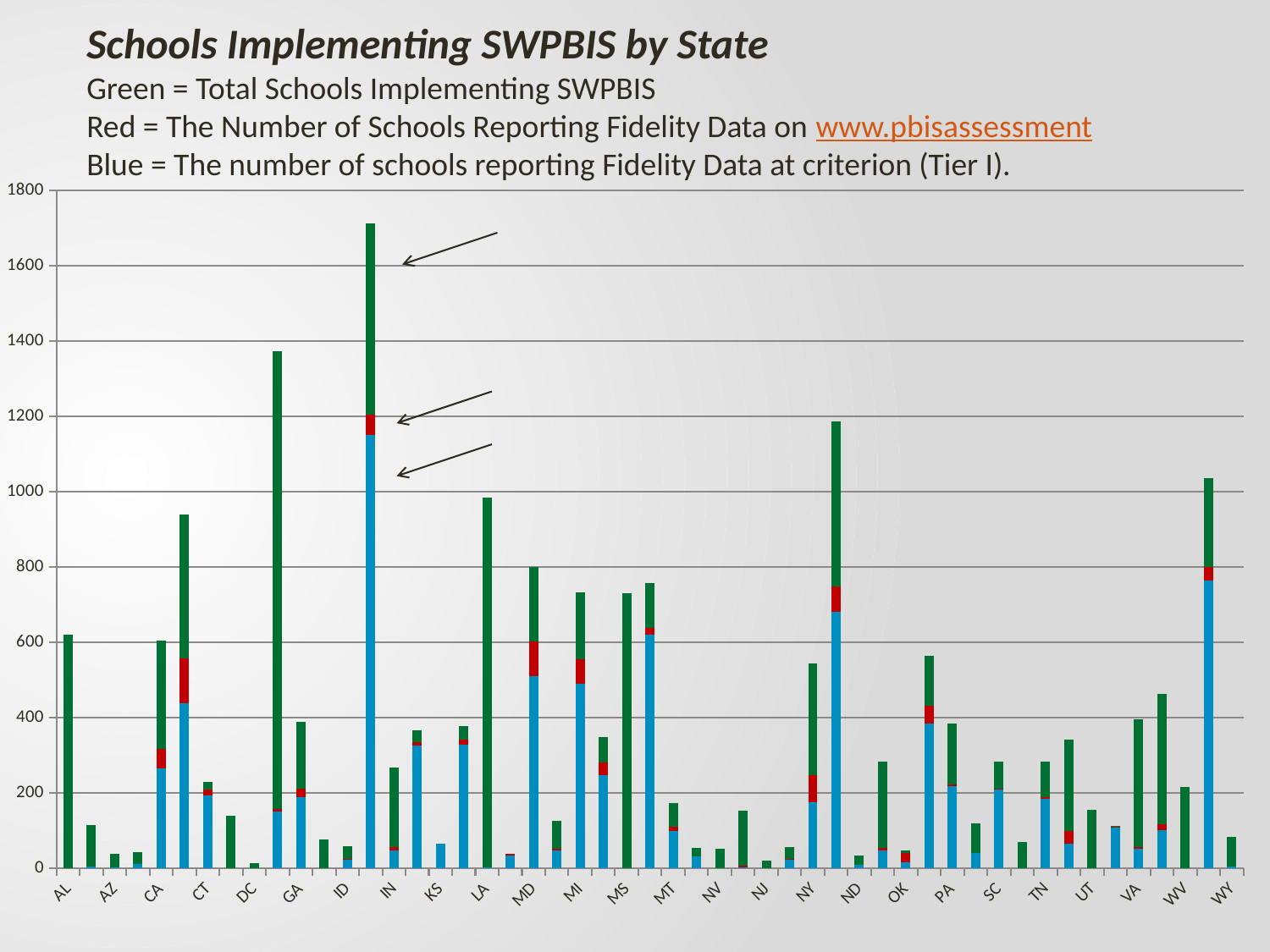
Is the total bar height for WY greater or less than 200? less Is the total bar height for NJ greater or less than 200? less What kind of chart is shown on the slide? bar chart According to the slide's key, what does the green colour represent? Total Schools Implementing SWPBIS How many series (colours) does the slide's key describe? 3 Which has the taller total bar, LA or DC? LA Is the total bar height for AL greater or less than 400? greater Which has the taller total bar, AL or AZ? AL What is the title of the chart? Schools Implementing SWPBIS by State